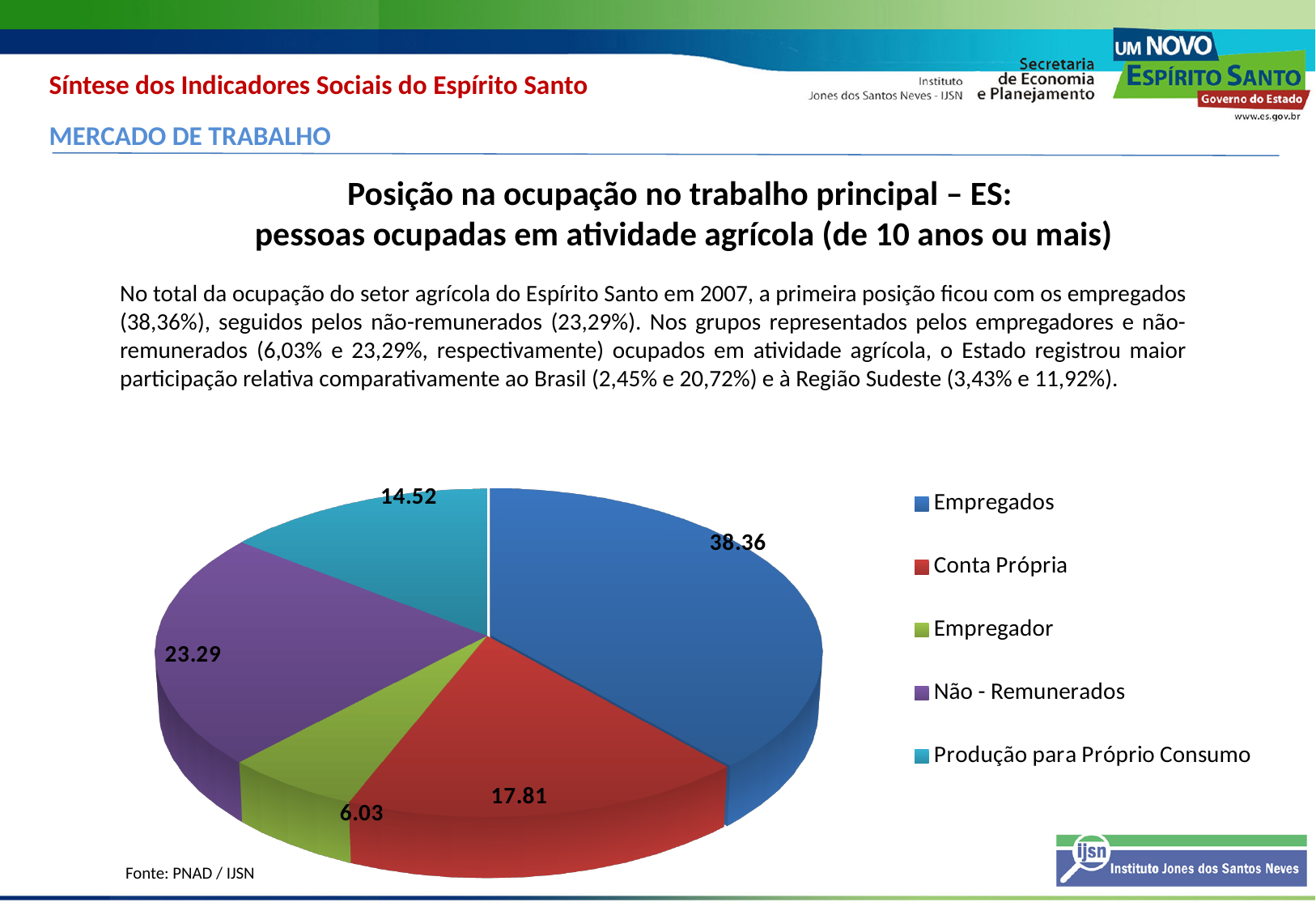
What value is shown for the Conta Própria slice? 17.81 What kind of chart is shown on the slide? Pie chart What value is shown for the Empregados slice of the pie chart? 38.36 What value is shown for the Produção para Próprio Consumo slice? 14.52 What is the difference between the Empregados value and the Não - Remunerados value? 15.07 Which is larger, the Conta Própria slice or the Produção para Próprio Consumo slice? Conta Própria How many categories does the pie chart show? 5 Which category has the largest slice of the pie? Empregados What colour is the Empregador slice in the pie chart? Green What is the difference between the Não - Remunerados value and the Conta Própria value? 5.48 Which category has the smallest slice of the pie? Empregador What share of the pie does the Não - Remunerados slice represent? 23.29